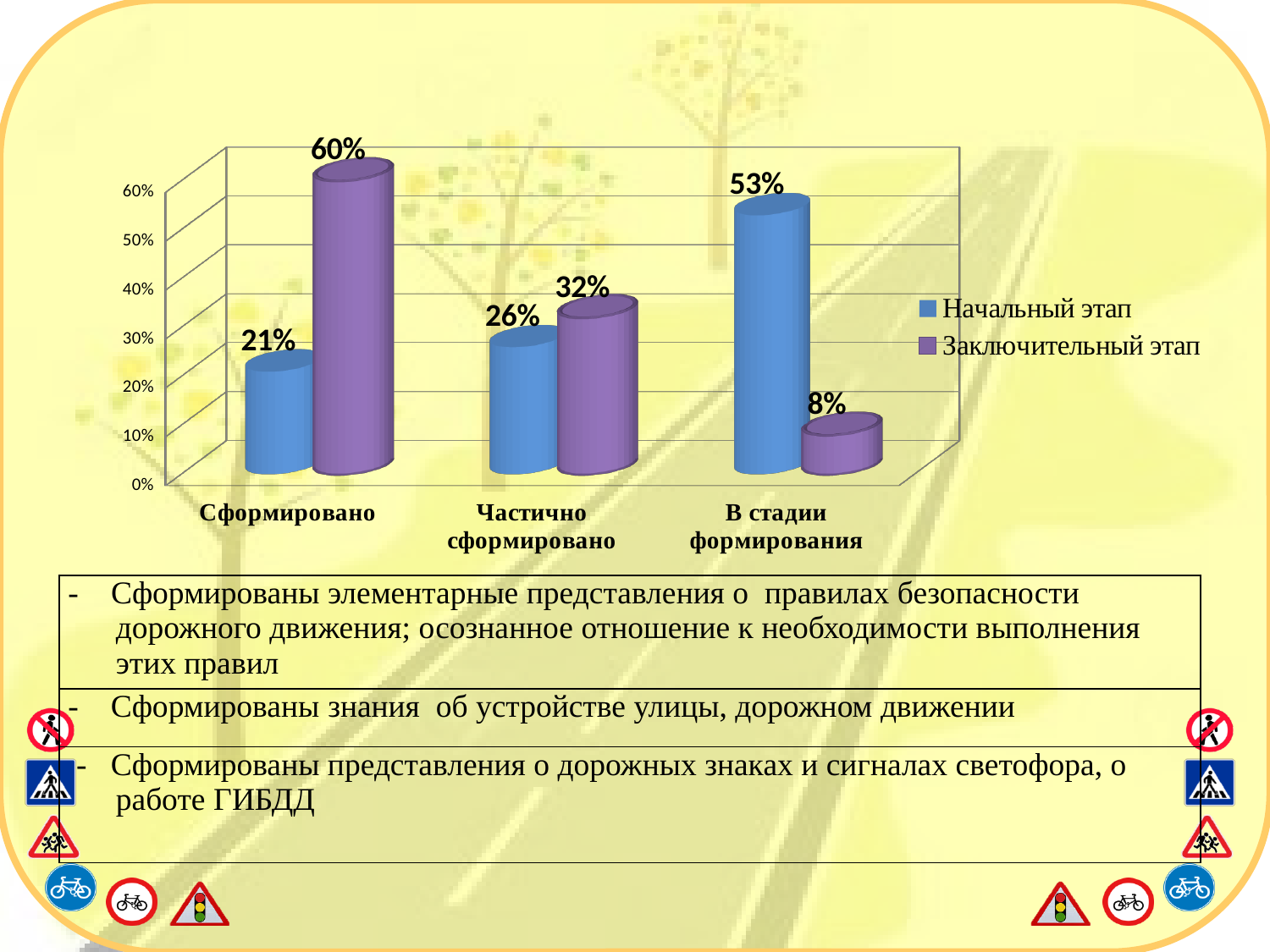
What is the value for Заключительный этап in the В стадии формирования category? 8% Which colour represents the Заключительный этап series? Purple Which category has the lowest value for the Заключительный этап series? В стадии формирования What is the difference between the Заключительный этап and Начальный этап values in the Сформировано category? 39% What kind of chart is shown on the slide? Bar chart In the Частично сформировано category, which series has the larger value? Заключительный этап How many series does the legend list? 2 Which category has the highest value for the Начальный этап series? В стадии формирования How many categories are shown on the x axis? 3 What is the value for Начальный этап in the Сформировано category? 21% What is the value for Заключительный этап in the Сформировано category? 60% What is the value for Начальный этап in the Частично сформировано category? 26%